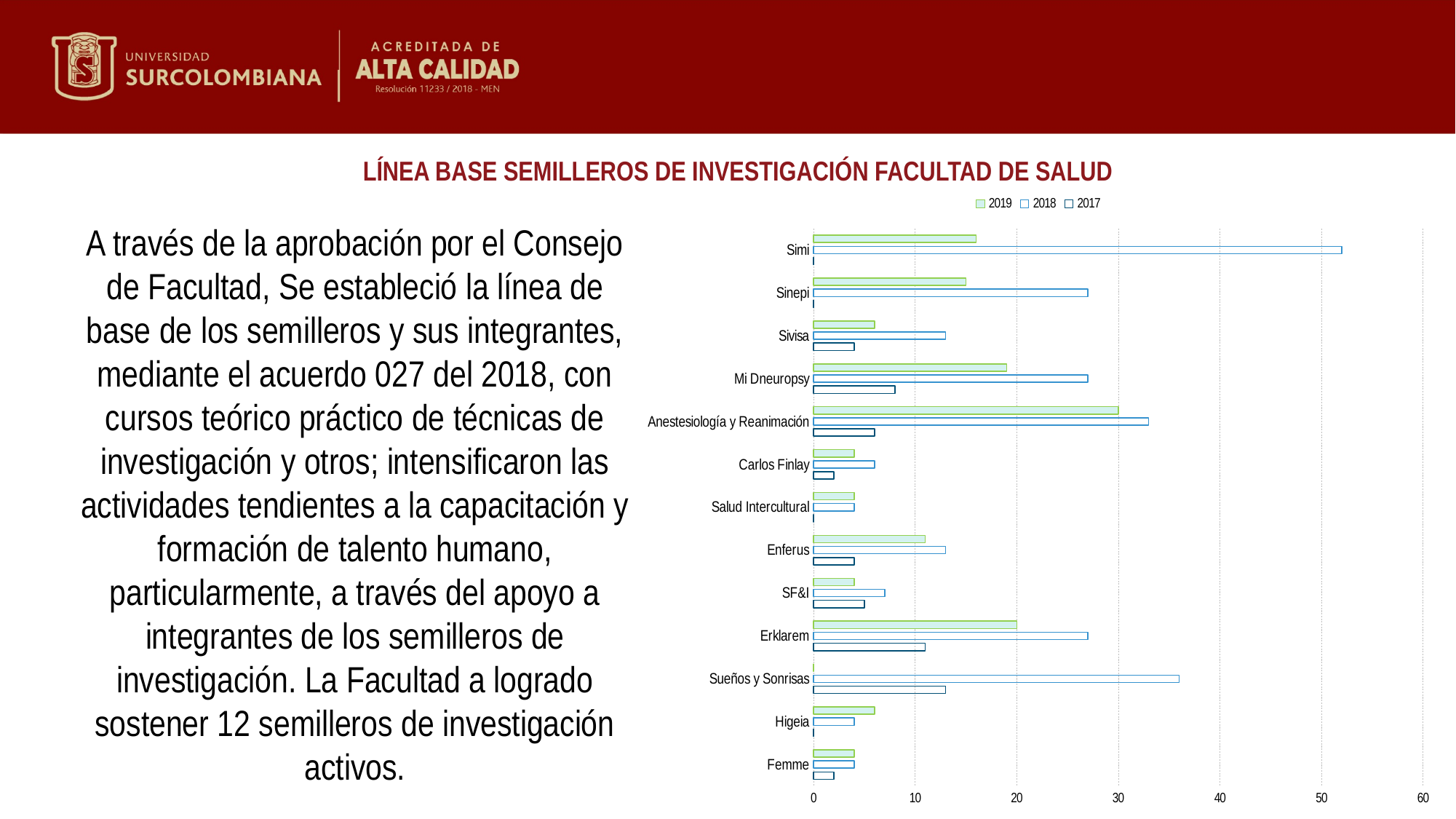
What kind of chart is shown on the slide? Bar chart Which category has the highest value for the 2018 series? Simi Is the 2018 value for Sueños y Sonrisas greater or less than 30? greater How many research groups (categories) are shown on the y axis of the chart? 13 How many series does the legend list? 3 Is the 2018 value for Simi greater or less than 50? greater Which is larger, the 2019 value for Anestesiología y Reanimación or the 2019 value for Carlos Finlay? Anestesiología y Reanimación Which is larger, the 2018 value for Simi or the 2018 value for Sinepi? Simi Which category has the highest value for the 2019 series? Anestesiología y Reanimación Is the 2019 value for Sivisa greater or less than 10? less Which category has the lowest value for the 2019 series? Sueños y Sonrisas Which years are listed in the chart legend? 2019, 2018, 2017